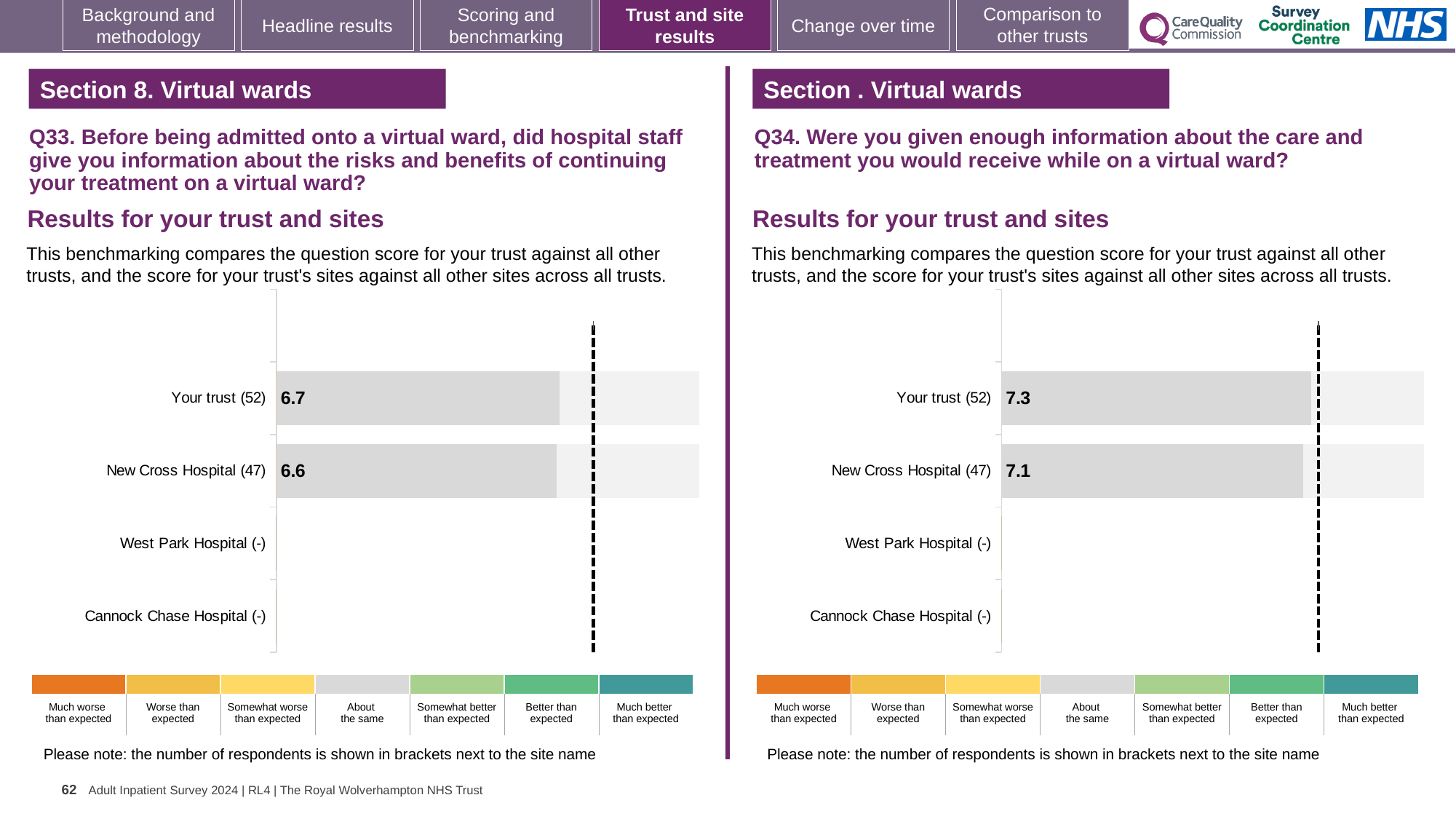
In the Q34 chart on the right, what is the score for Your trust? 7.3 In the Q34 chart on the right, which categories have no bar plotted? West Park Hospital and Cannock Chase Hospital In the Q34 chart on the right, what is the score for New Cross Hospital? 7.1 In the Q33 chart on the left, what is the difference between the score for Your trust and the score for New Cross Hospital? 0.1 What kind of chart is the Q34 chart on the right? Bar chart In the Q33 chart on the left, what is the score for New Cross Hospital? 6.6 In the Q33 chart on the left, how many respondents are shown in brackets for New Cross Hospital? 47 In the Q33 chart on the left, how many respondents are shown in brackets for Your trust? 52 How many site or trust categories are listed on the y axis of the Q33 chart on the left? 4 In the Q34 chart on the right, which has the higher score, Your trust or New Cross Hospital? Your trust In the Q33 chart on the left, what is the score for Your trust? 6.7 In the Q34 chart on the right, what is the difference between the score for Your trust and the score for New Cross Hospital? 0.2